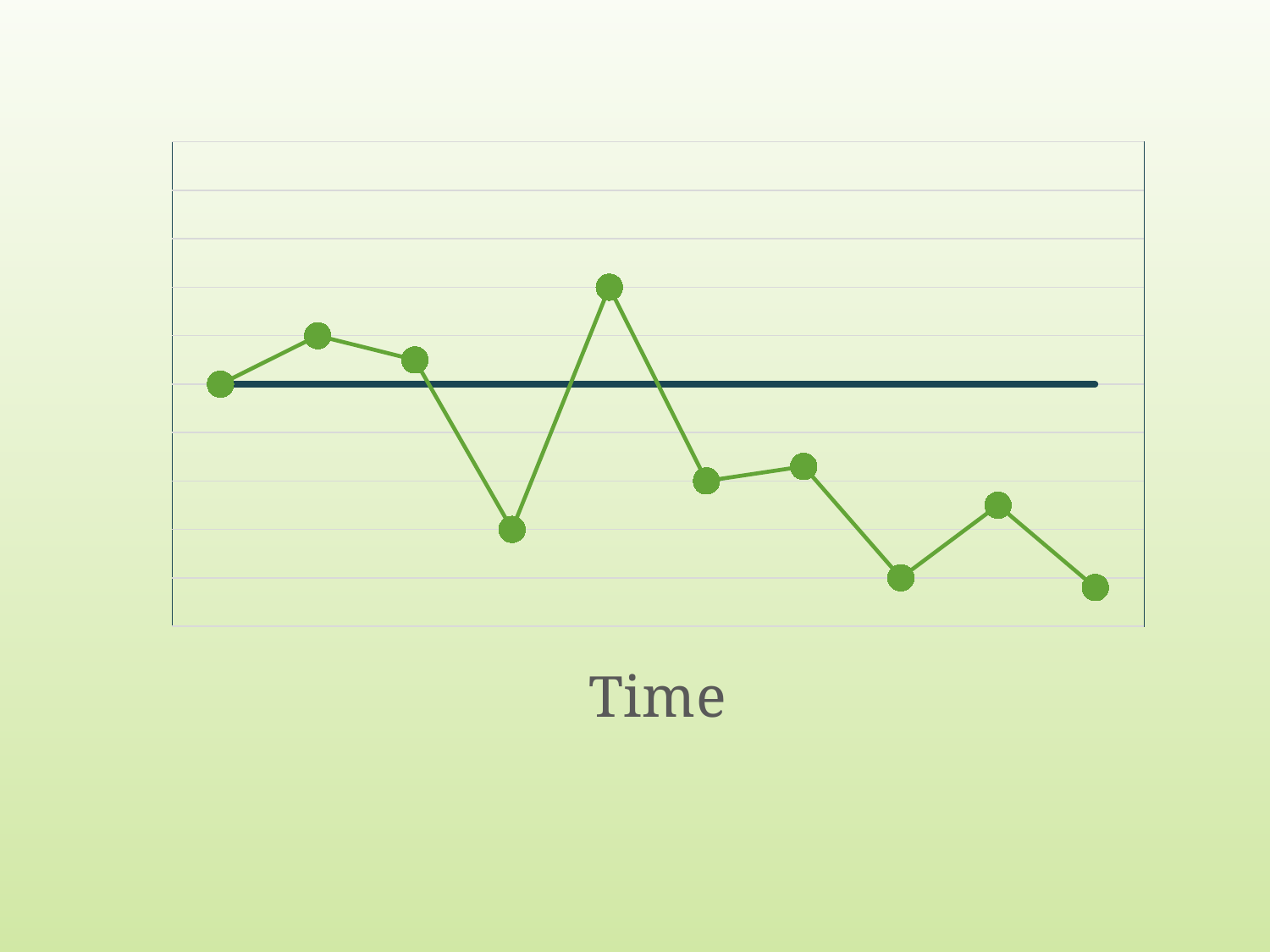
What is the title of the x axis? Time How many of the green data points lie above the dark horizontal line? 3 Do the values on the green line generally rise or fall from left to right? fall How many data points are plotted on the green line? 10 Which is larger, the first data point or the last data point on the green line? the first data point Which is larger, the 4th data point or the 5th data point on the green line? the 5th data point What kind of chart is shown on the slide? line chart Which data point on the green line is the highest: the 2nd, the 5th or the 8th? the 5th What colour is the line with the circular markers? green Is the 6th data point on the green line above or below the dark horizontal line? below Which data point on the green line is the lowest: the 4th, the 8th or the 10th? the 10th